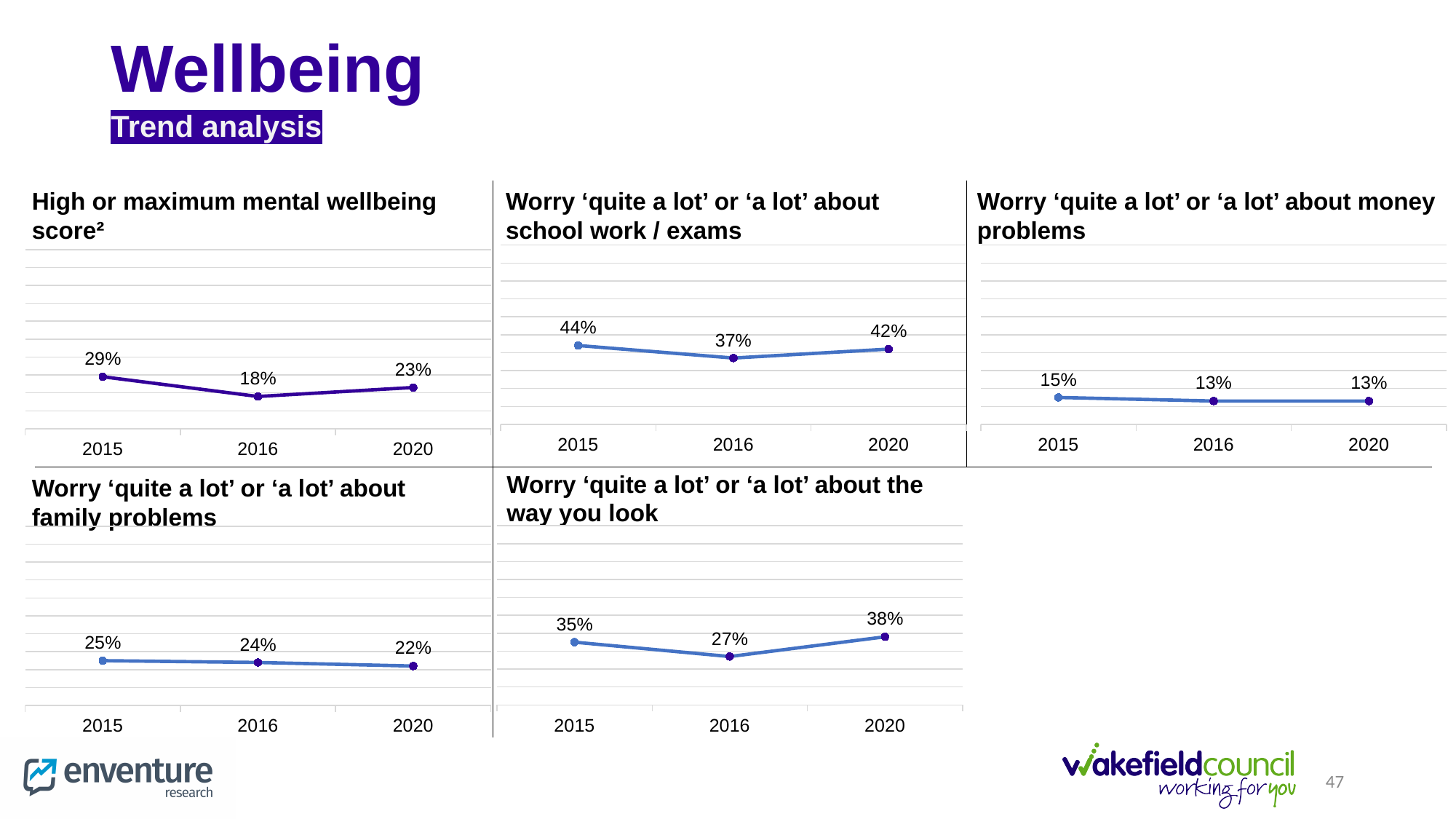
In the 'High or maximum mental wellbeing score' chart, what is the difference between the 2015 and 2016 values? 11 percentage points In the 'Worry about family problems' chart, which year has the lowest value? 2020 How many charts are shown on the slide? 5 How many data points are plotted in the 'Worry about family problems' chart? 3 In the 'Worry about the way you look' chart, what is the difference between the 2020 and 2016 values? 11 percentage points What kind of chart is the 'Worry about money problems' chart? Line chart In the 'Worry about family problems' chart, do the values rise or fall from 2015 to 2020? Fall In the 'Worry about money problems' chart, which year has the highest value? 2015 In the 'High or maximum mental wellbeing score' chart, what is the value for 2016? 18% In the 'Worry about school work / exams' chart, what is the value for 2020? 42% In the 'Worry about the way you look' chart, what is the value for 2015? 35% In the 'Worry about school work / exams' chart, which is larger, the value for 2015 or the value for 2020? 2015